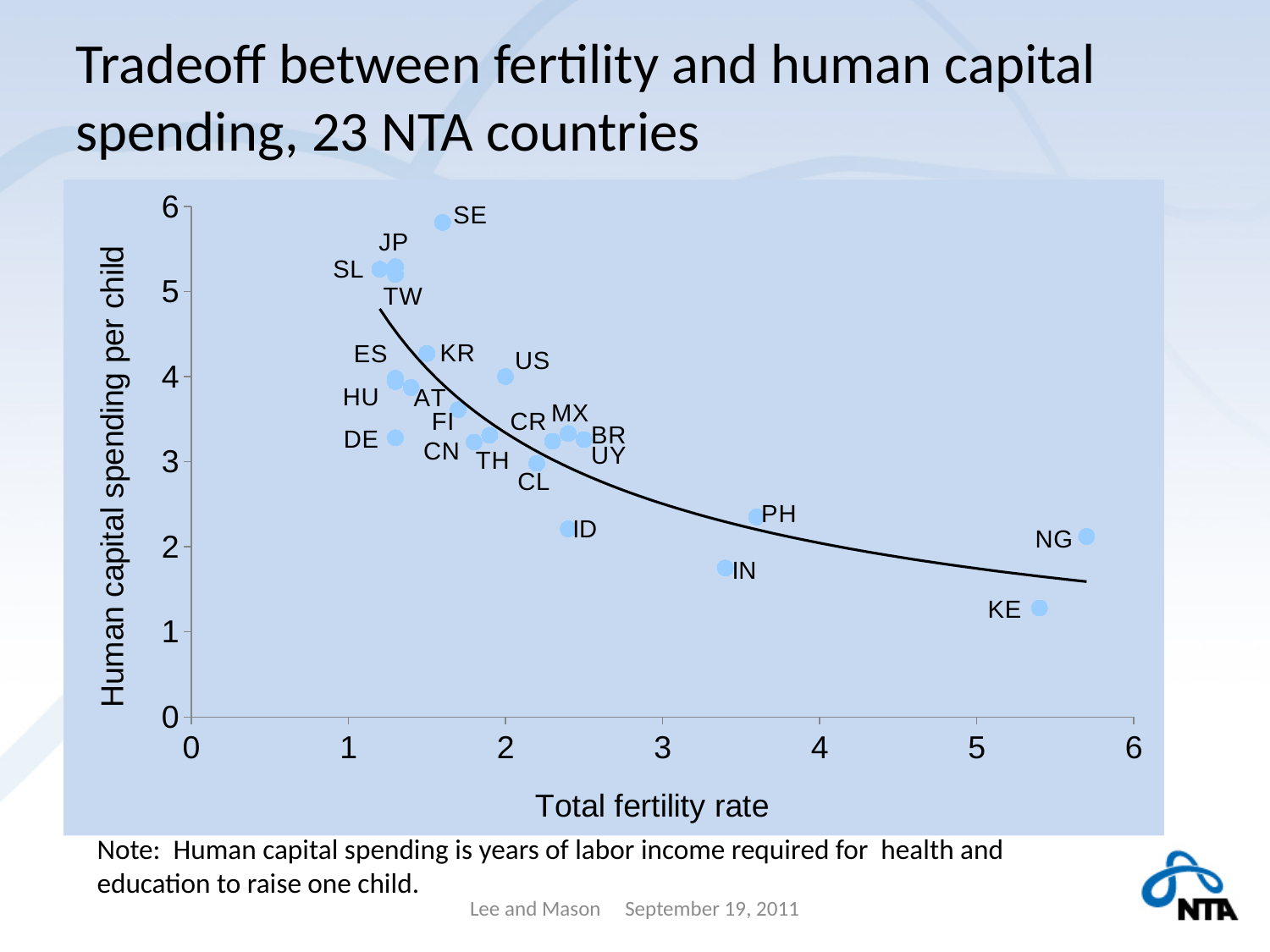
What kind of chart is shown on the slide? scatter chart Is the human capital spending per child for SE greater or less than 5? greater Is the total fertility rate for NG greater or less than 5? greater What is the title of the x axis? Total fertility rate How many countries are plotted in the chart? 23 Which country has the highest total fertility rate? NG Which country has the lowest human capital spending per child? KE Is the human capital spending per child for KE greater or less than 2? less As total fertility rate increases, does human capital spending per child generally rise or fall? fall Which country has the highest human capital spending per child? SE Which has higher human capital spending per child, US or ID? US